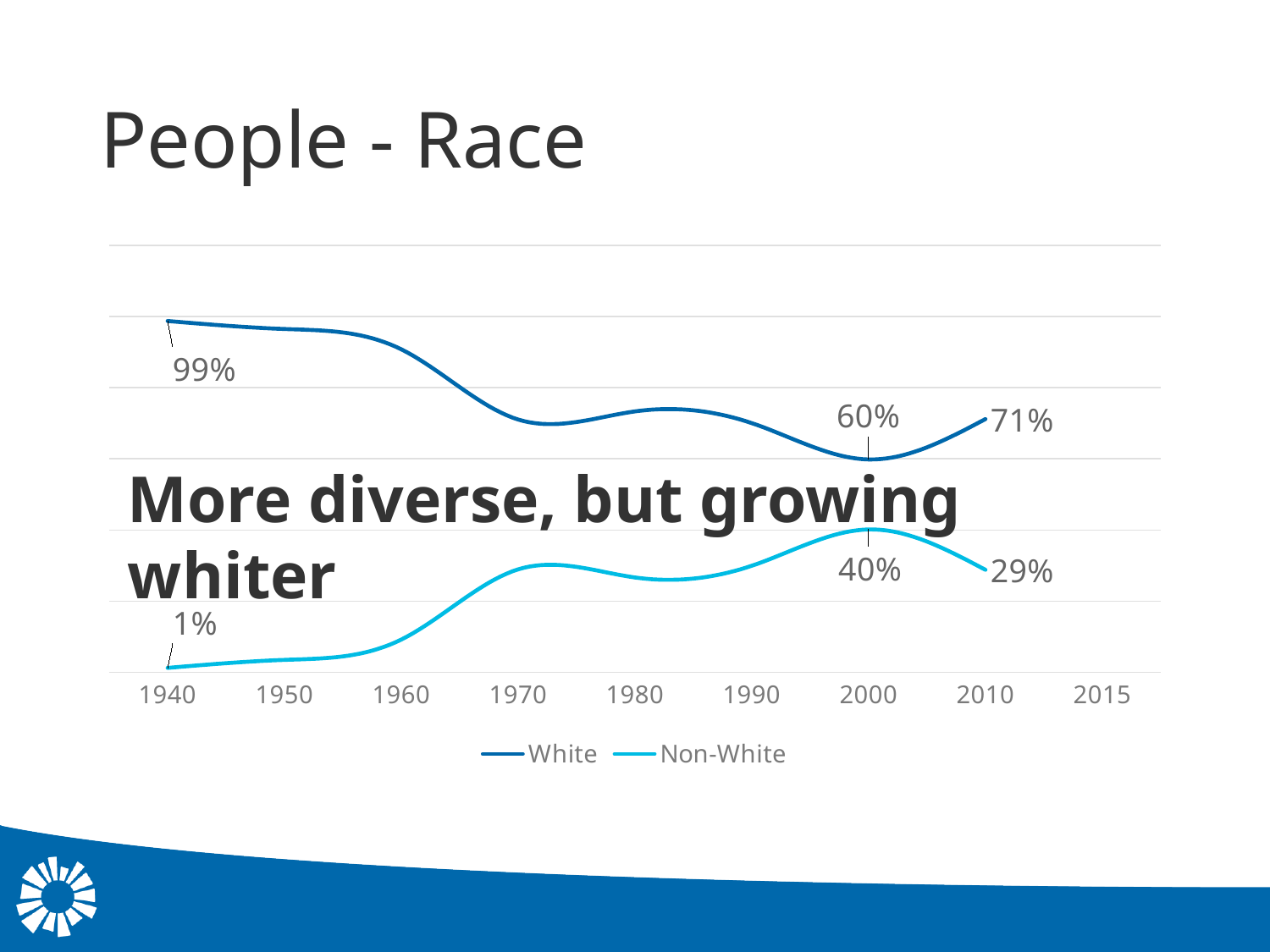
Does the White line rise or fall from 1940 to 2000? Fall What is the value for White in 2000? 60% By how many percentage points did the White share change from 2000 to 2010? 11 percentage points How many series does the legend list? 2 What is the value for Non-White in 2000? 40% Which year has the larger White value, 2000 or 2010? 2010 What is the value for Non-White in 1940? 1% What is the value for White in 1940? 99% What is the value for White in 2010? 71% What is the value for Non-White in 2010? 29% What is the difference between the White and Non-White values in 2010? 42 percentage points What kind of chart is shown on the slide? Line chart